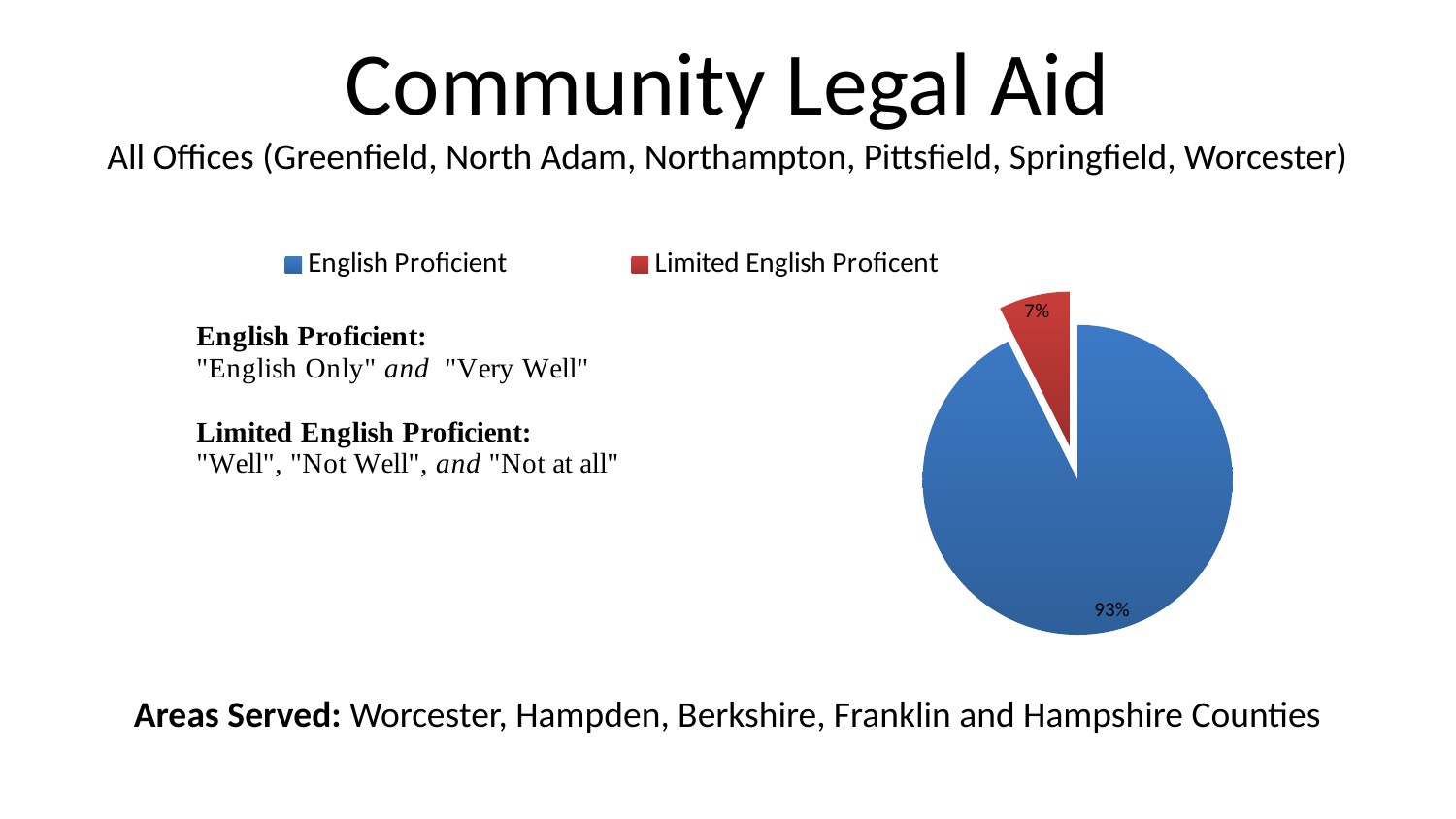
What share of the pie is Limited English Proficent? 7% What is the difference in percentage points between the English Proficient and Limited English Proficent slices? 86 What colour is the Limited English Proficent slice? red How many entries does the legend list? 2 Which category has the smallest slice of the pie? Limited English Proficent What colour is the English Proficient slice? blue Which is larger, the English Proficient slice or the Limited English Proficent slice? English Proficient What kind of chart is shown on the slide? pie chart What share of the pie is English Proficient? 93% Which category has the largest slice of the pie? English Proficient How many slices does the pie chart have? 2